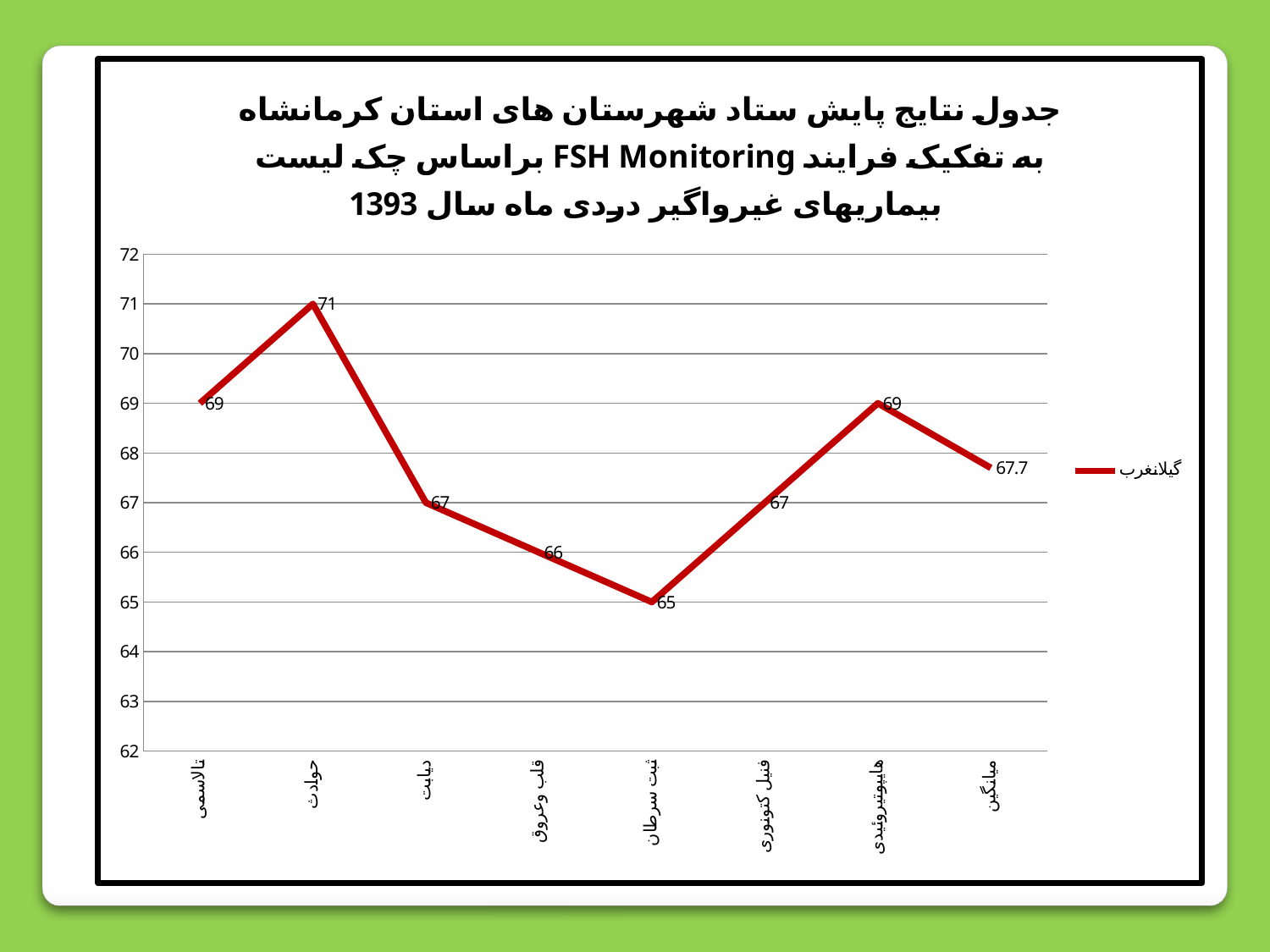
What is the value for حوادث? 71 How many series does the legend list? 1 What is the value for ثبت سرطان? 65 Which category has the highest value? حوادث What is the value for قلب وعروق? 66 What kind of chart is this? line chart What is the value for میانگین? 67.7 What is the difference between the values for حوادث and ثبت سرطان? 6 Which is larger, the value for تالاسمی or the value for دیابت? تالاسمی How many categories are shown on the x axis? 8 What is the legend entry for the plotted series? گیلانغرب Which category has the lowest value? ثبت سرطان